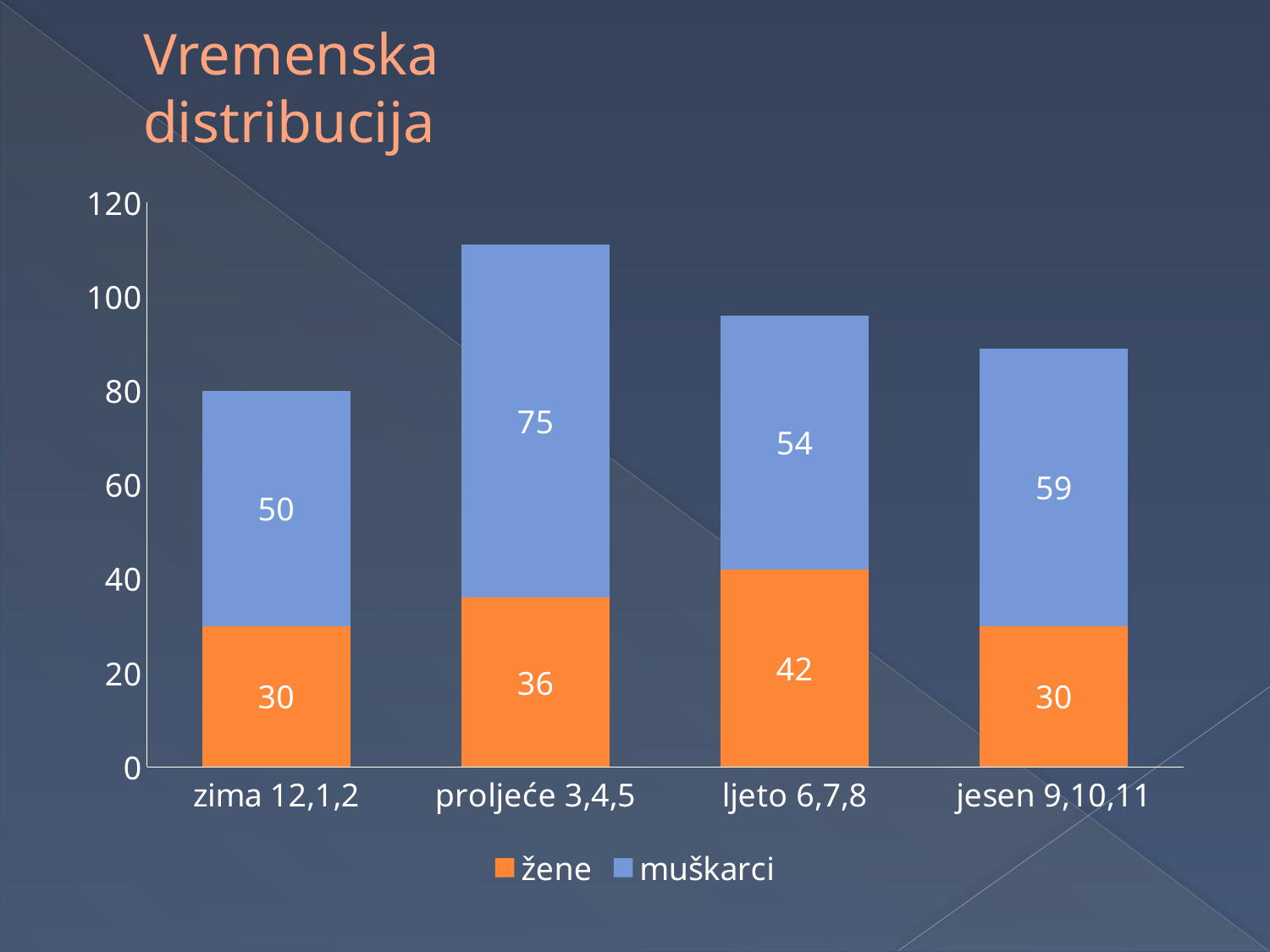
What is the total of the stacked bar for proljeće 3,4,5? 111 Which is larger: žene in ljeto 6,7,8 or žene in proljeće 3,4,5? žene in ljeto 6,7,8 What is the value for žene in ljeto 6,7,8? 42 How many series does the legend list? 2 What kind of chart is shown on the slide? Stacked bar chart How many categories are shown on the x axis? 4 What is the value for muškarci in jesen 9,10,11? 59 Which category has the highest value for muškarci? proljeće 3,4,5 Which category has the lowest value for žene? zima 12,1,2 and jesen 9,10,11 What is the value for žene in zima 12,1,2? 30 What is the difference between the muškarci values for proljeće 3,4,5 and ljeto 6,7,8? 21 What is the value for muškarci in proljeće 3,4,5? 75